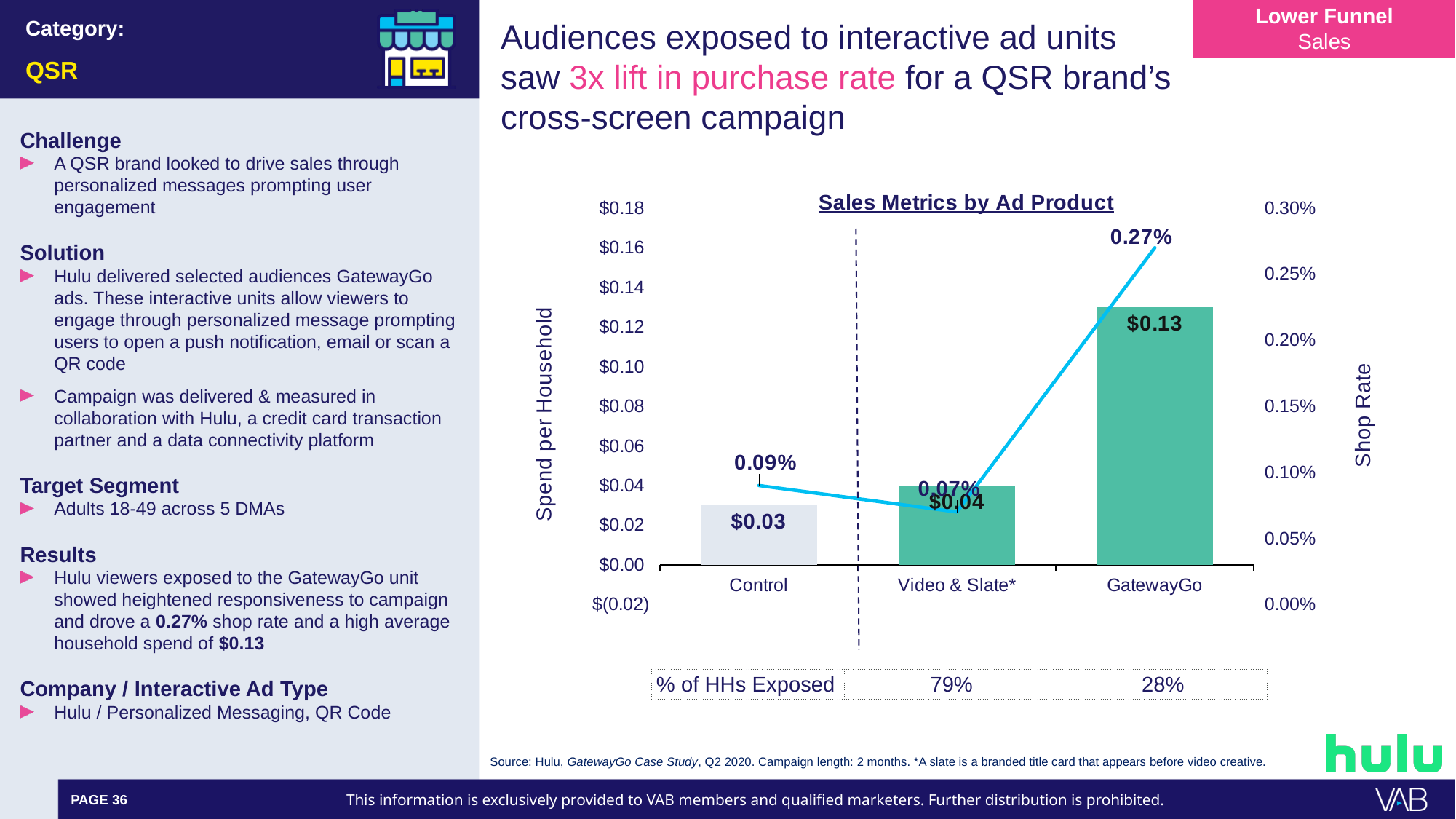
What is the shop rate for Control? 0.09% What is the spend per household for Video & Slate*? $0.04 What is the shop rate for GatewayGo? 0.27% What is the title of the chart? Sales Metrics by Ad Product How many ad product categories are shown on the x axis? 3 Which has a higher shop rate, Control or GatewayGo? GatewayGo Which ad product has the highest spend per household? GatewayGo What is the % of HHs Exposed for Video & Slate*? 79% What is the spend per household for Control? $0.03 What is the spend per household for GatewayGo? $0.13 What is the difference in spend per household between GatewayGo and Control? $0.10 Which ad product has the lowest shop rate? Video & Slate*